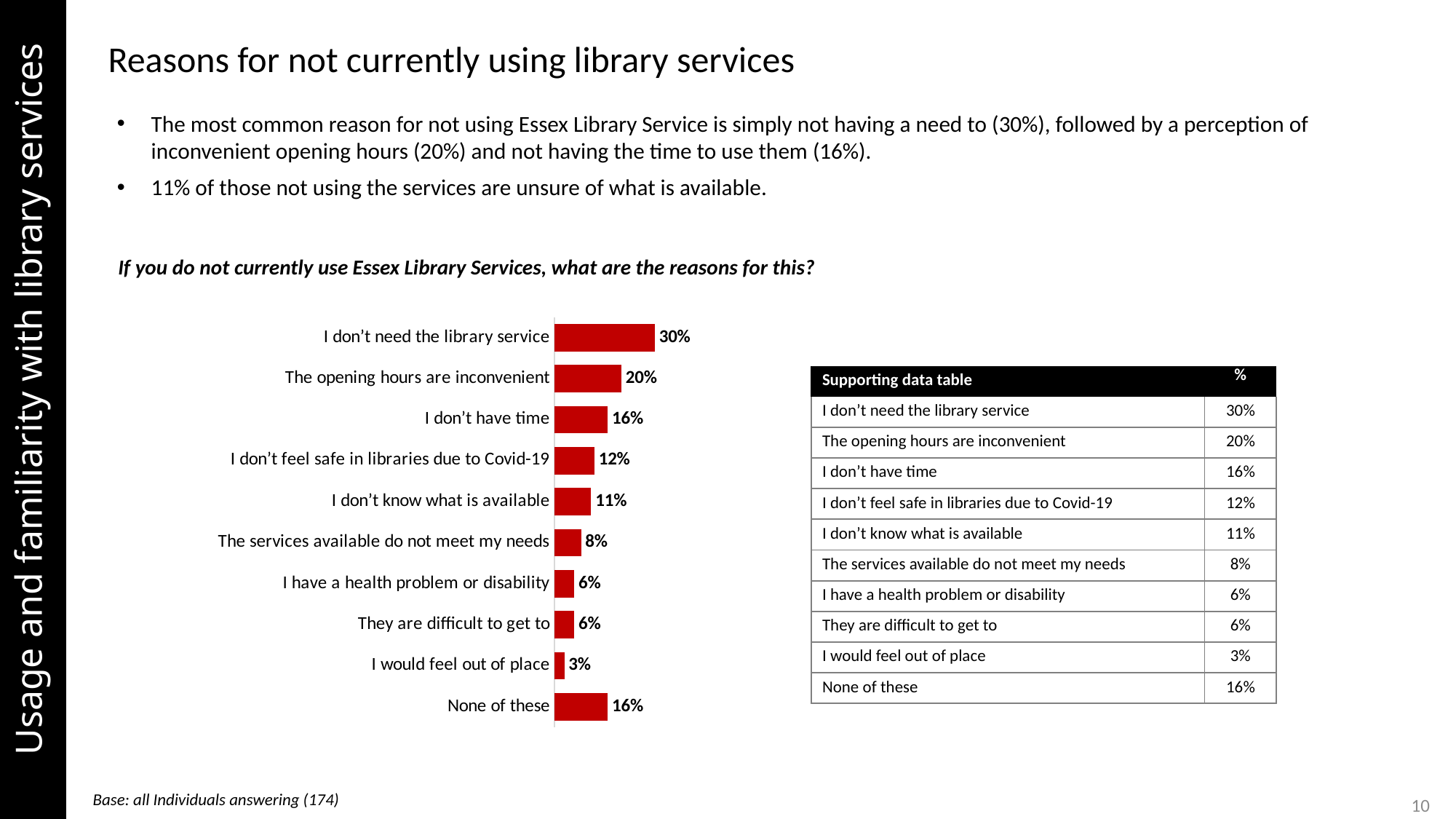
Which is larger: 'I don't know what is available' or 'The services available do not meet my needs'? I don't know what is available What colour are the bars in the chart? Red Which reason has the lowest percentage? I would feel out of place What is the difference between 'I don't have time' and 'I would feel out of place'? 13 percentage points What is the value for 'None of these'? 16% What is the value for 'The opening hours are inconvenient'? 20% Which reason has the highest percentage? I don't need the library service What percentage of respondents said 'I don't need the library service'? 30% What is the difference between 'I don't need the library service' and 'The opening hours are inconvenient'? 10 percentage points How many categories are shown in the chart? 10 What percentage is shown for 'I don't feel safe in libraries due to Covid-19'? 12% What type of chart is shown on the slide? Bar chart